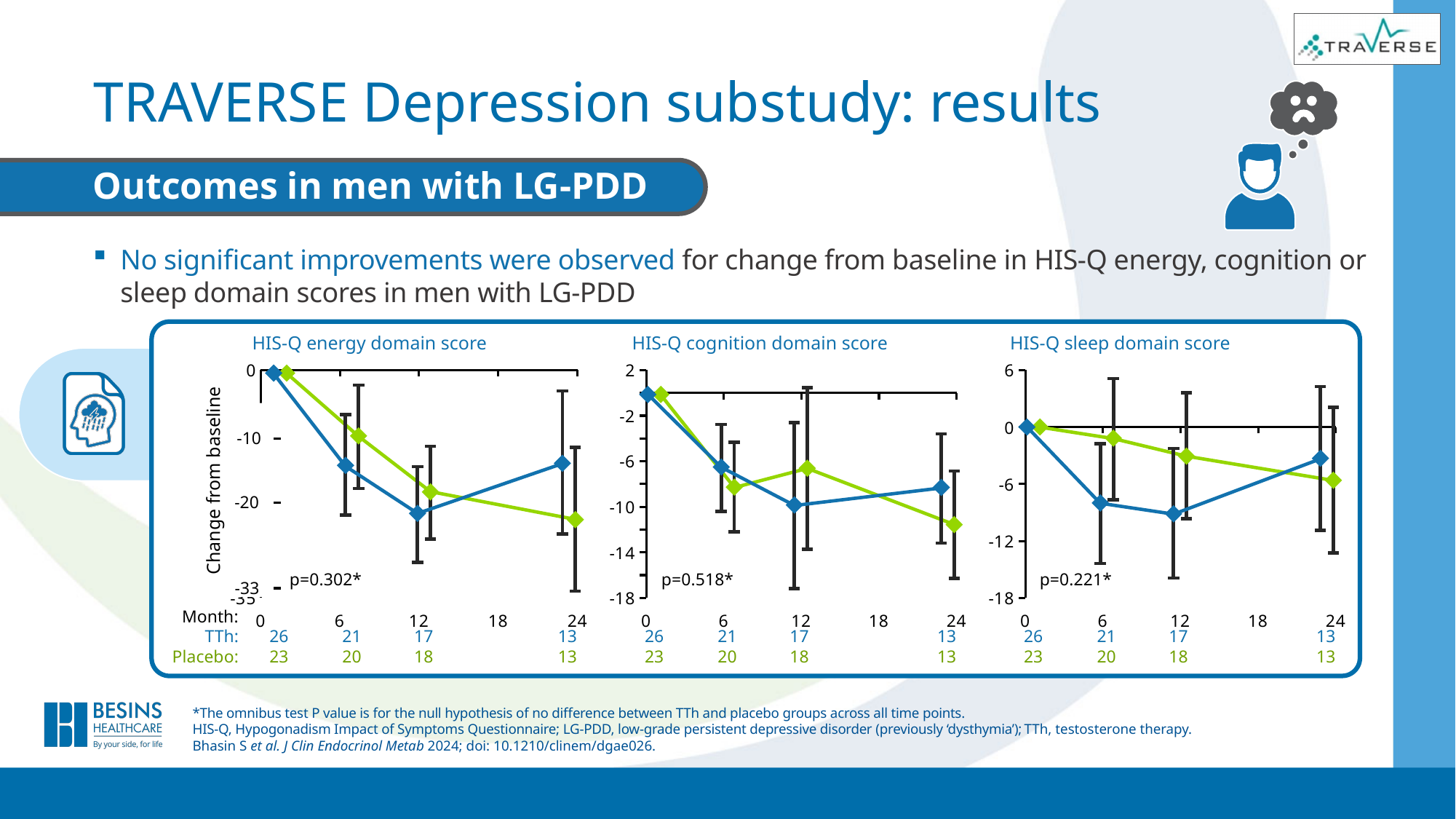
In the HIS-Q energy domain score chart, is the TTh value at month 6 greater or less than -10? less What is the omnibus test p value printed on the HIS-Q cognition domain score chart? p=0.518* What is the omnibus test p value printed on the HIS-Q sleep domain score chart? p=0.221* In the HIS-Q sleep domain score chart, is the Placebo value at month 12 greater or less than -6? greater In the HIS-Q energy domain score chart, is the TTh value at month 12 greater or less than -20? less How many charts are shown inside the boxed panel on the slide? 3 What kind of chart is the HIS-Q energy domain score chart? line chart In the HIS-Q sleep domain score chart, which group has the higher value at month 12, TTh or Placebo? Placebo In the HIS-Q energy domain score chart, which group has the higher value at month 24, TTh or Placebo? TTh In the HIS-Q sleep domain score chart, how many time points are plotted for each series? 4